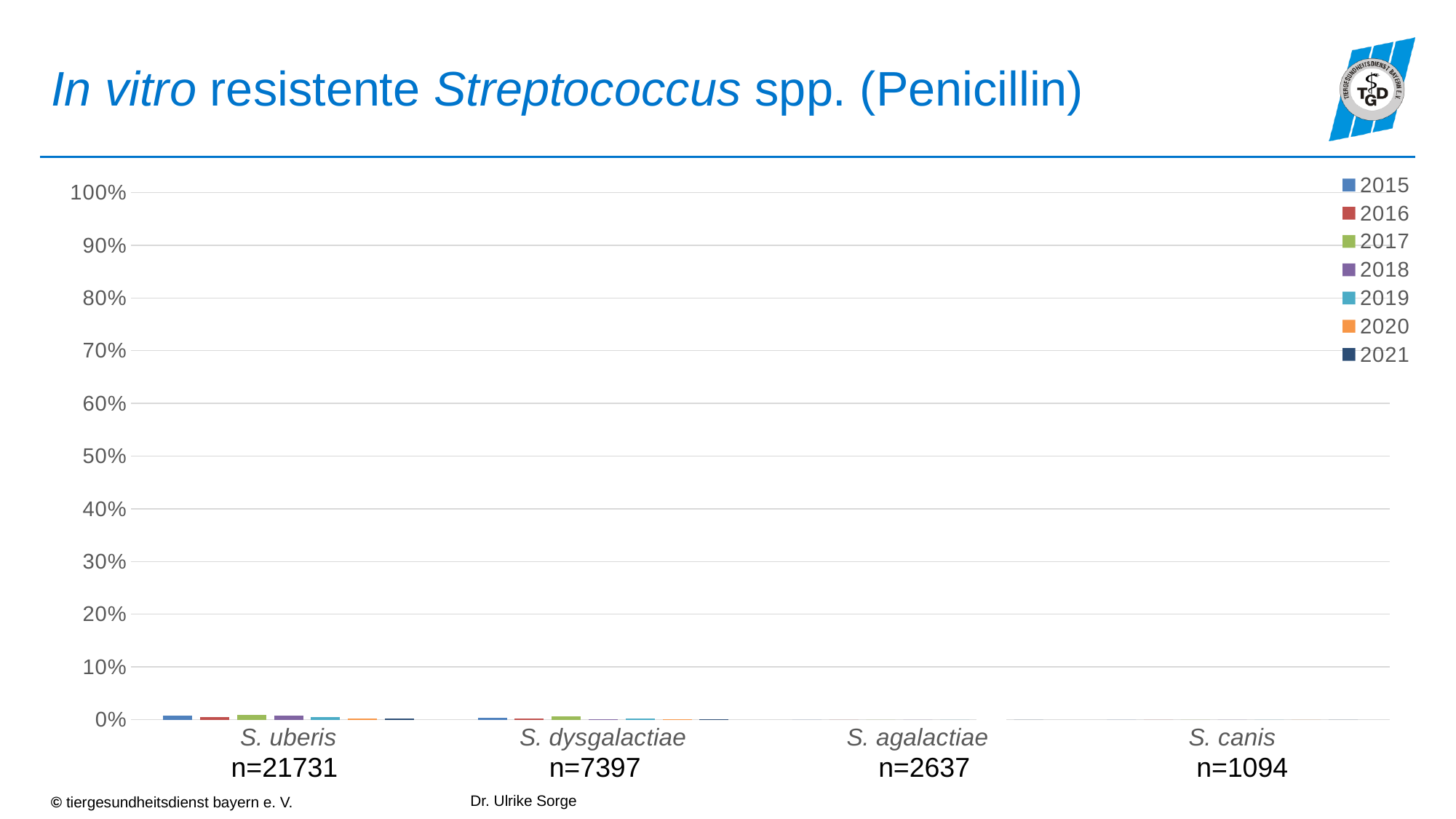
What is the first year listed in the legend? 2015 Is the value for S. uberis in 2017 greater or less than 10%? less Is the value for S. canis in 2021 greater or less than 10%? less What kind of chart is shown on the slide? bar chart What sample size (n) is given for S. uberis? n=21731 How many series (years) does the legend list? 7 How many Streptococcus species categories are shown on the x axis? 4 Is the value for S. agalactiae in 2019 greater or less than 20%? less